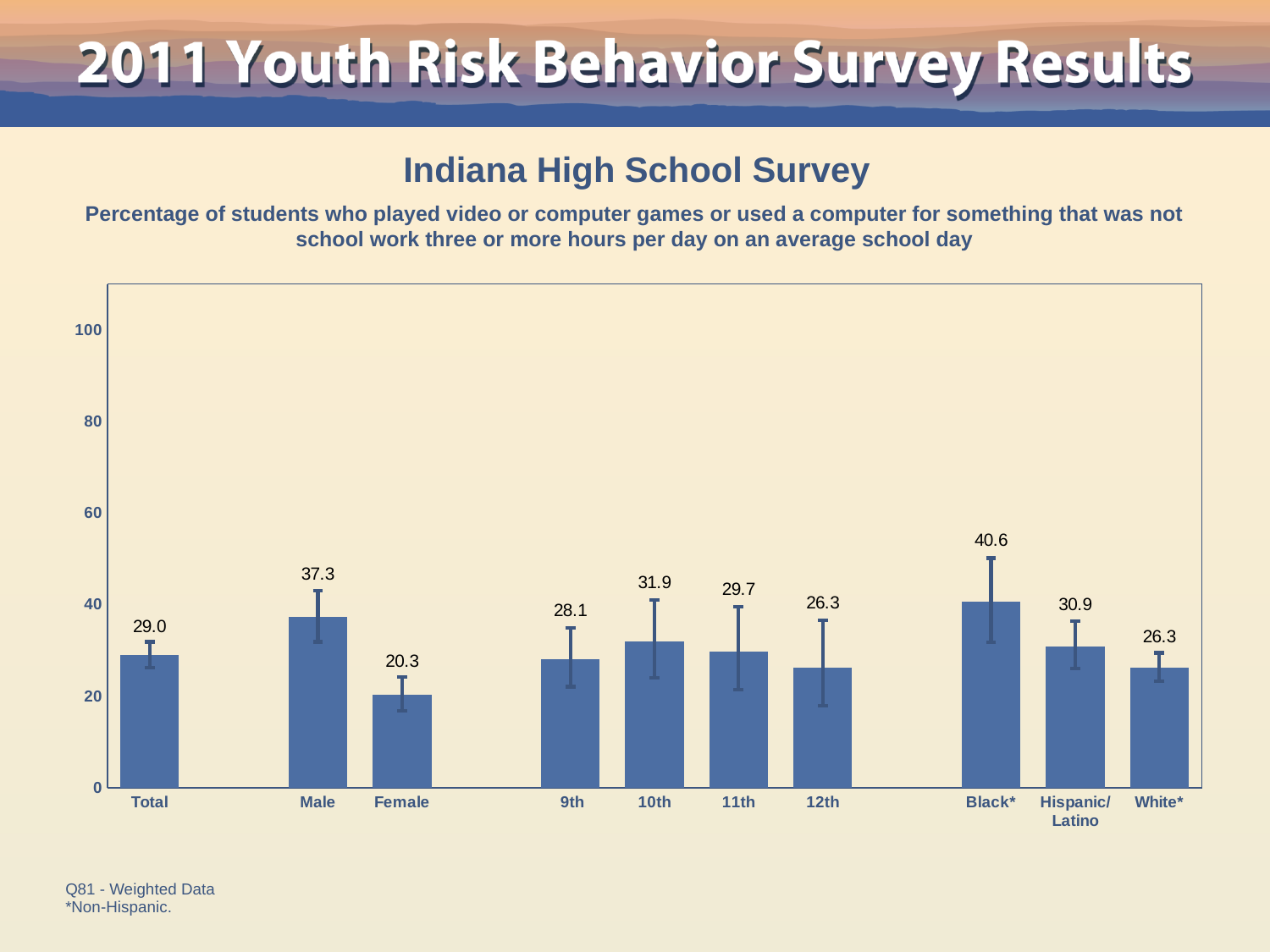
What kind of chart is shown on the slide? bar chart What is the value for Male? 37.3 How many categories are shown on the x axis? 10 Do the values rise or fall from 10th to 12th grade? fall What is the value for 10th? 31.9 Which is larger, the value for 9th or the value for 10th? 10th What is the value for Black*? 40.6 What is the value for Female? 20.3 Which category has the lowest value? Female What is the difference between the values for Male and Female? 17.0 Is the value for Black* greater or less than 40? greater Which category has the highest value? Black*